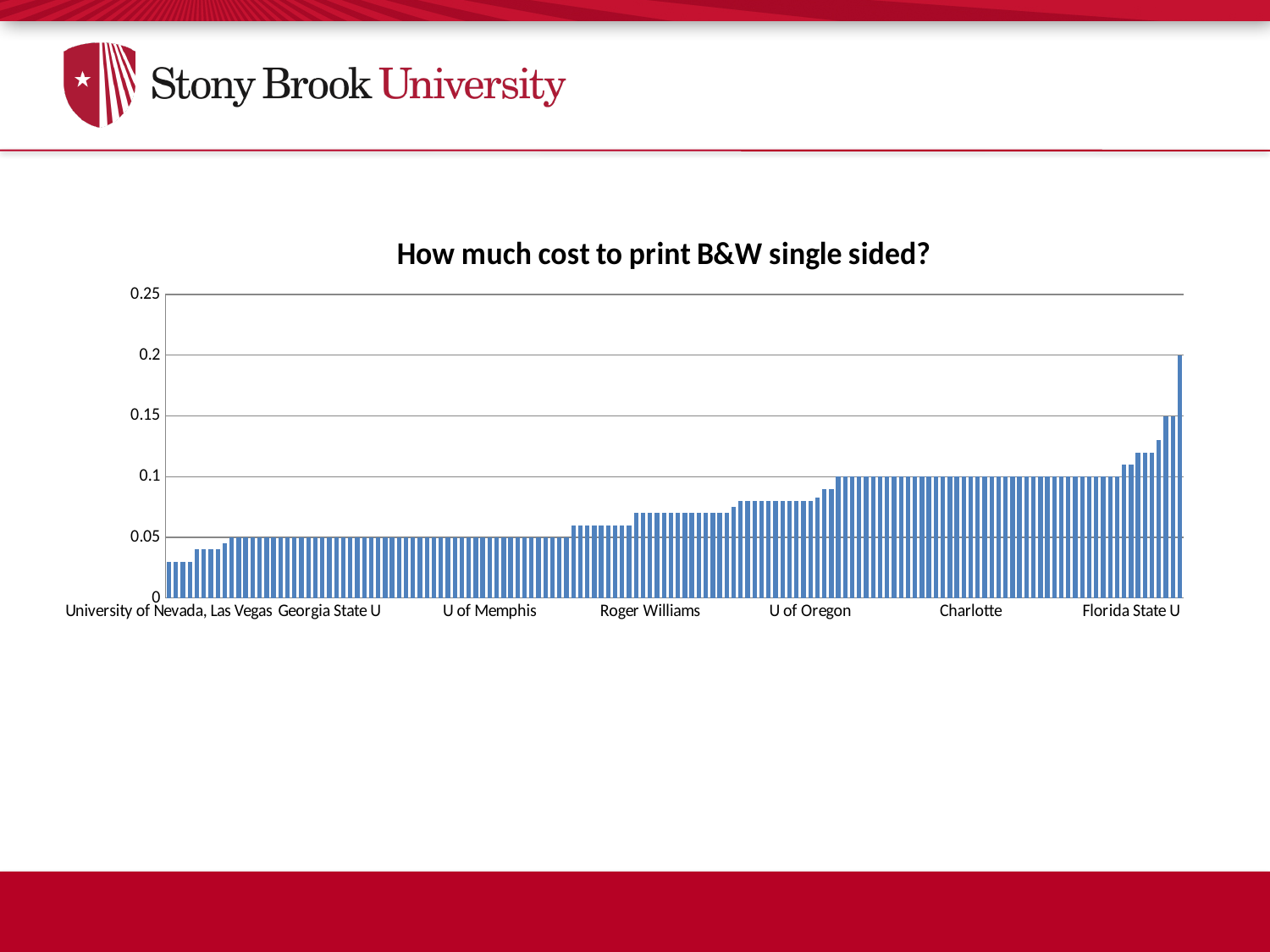
What is the value for Charlotte? 0.1 Which is larger, the value for Florida State U or the value for U of Memphis? Florida State U Is the value for U of Oregon greater or less than 0.1? less Do the values rise or fall moving from left to right along the x axis? rise Which labelled university has the lowest value? University of Nevada, Las Vegas What kind of chart is shown on the slide? bar chart Which labelled university has the highest value? Florida State U What is the value for Georgia State U? 0.05 Is the value for Roger Williams greater or less than 0.05? greater Is the value for University of Nevada, Las Vegas greater or less than 0.05? less What is the title of the chart? How much cost to print B&W single sided?